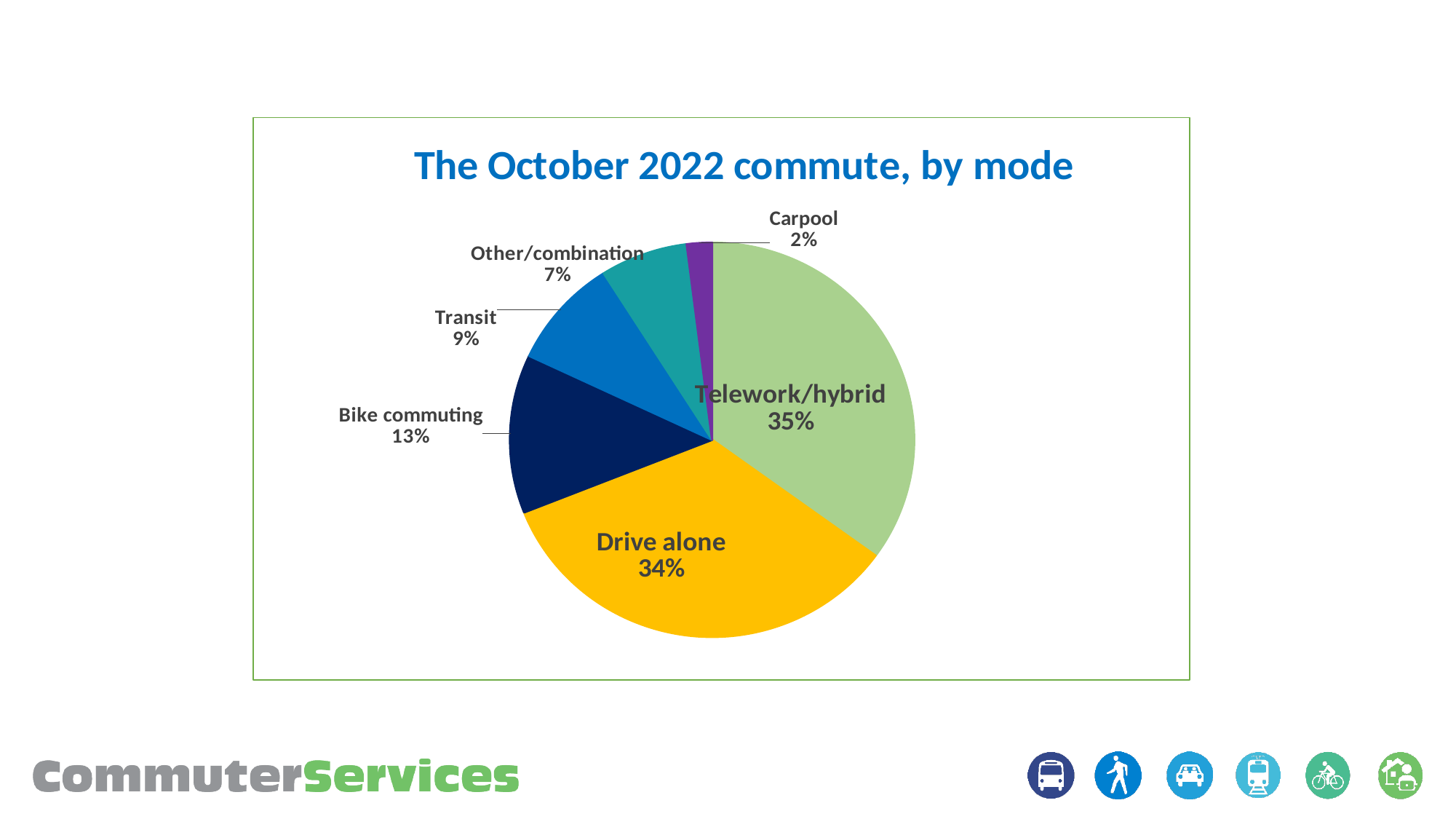
What is the difference in percentage points between Bike commuting and Transit? 4 Which commute mode has the smallest share in the pie chart? Carpool How many commute modes are shown in the pie chart? 6 What share of the October 2022 commute is Bike commuting? 13% What is the title of the chart? The October 2022 commute, by mode Which commute mode has the largest share in the pie chart? Telework/hybrid What share of the October 2022 commute is Drive alone? 34% What share of the October 2022 commute is Transit? 9% What kind of chart is shown on the slide? Pie chart What share of the October 2022 commute is Telework/hybrid? 35% Which has a larger share, Other/combination or Transit? Transit What share of the October 2022 commute is Carpool? 2%